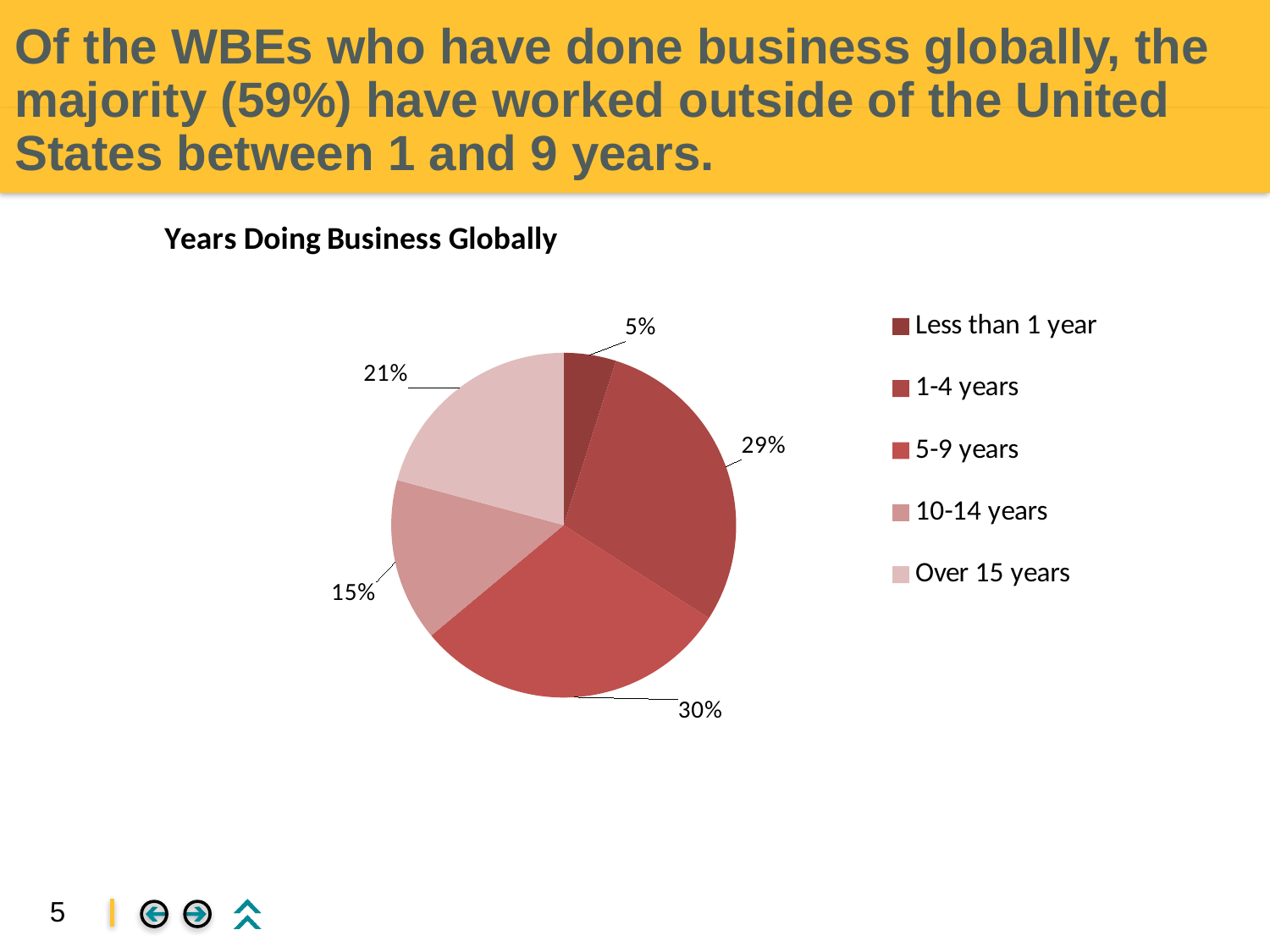
Which category has the smallest share of the pie? Less than 1 year How many categories does the legend list? 5 What share of WBEs have done business globally for 1-4 years? 29% What share of WBEs have done business globally for over 15 years? 21% What is the difference in percentage points between the 'Over 15 years' and '10-14 years' slices? 6 What share of WBEs have done business globally for 5-9 years? 30% Which category has the largest share of the pie? 5-9 years What share of WBEs have done business globally for 10-14 years? 15% What is the title of the chart? Years Doing Business Globally Which is larger, the share for 10-14 years or the share for over 15 years? Over 15 years What share of WBEs have done business globally for less than 1 year? 5% What kind of chart is shown on the slide? pie chart